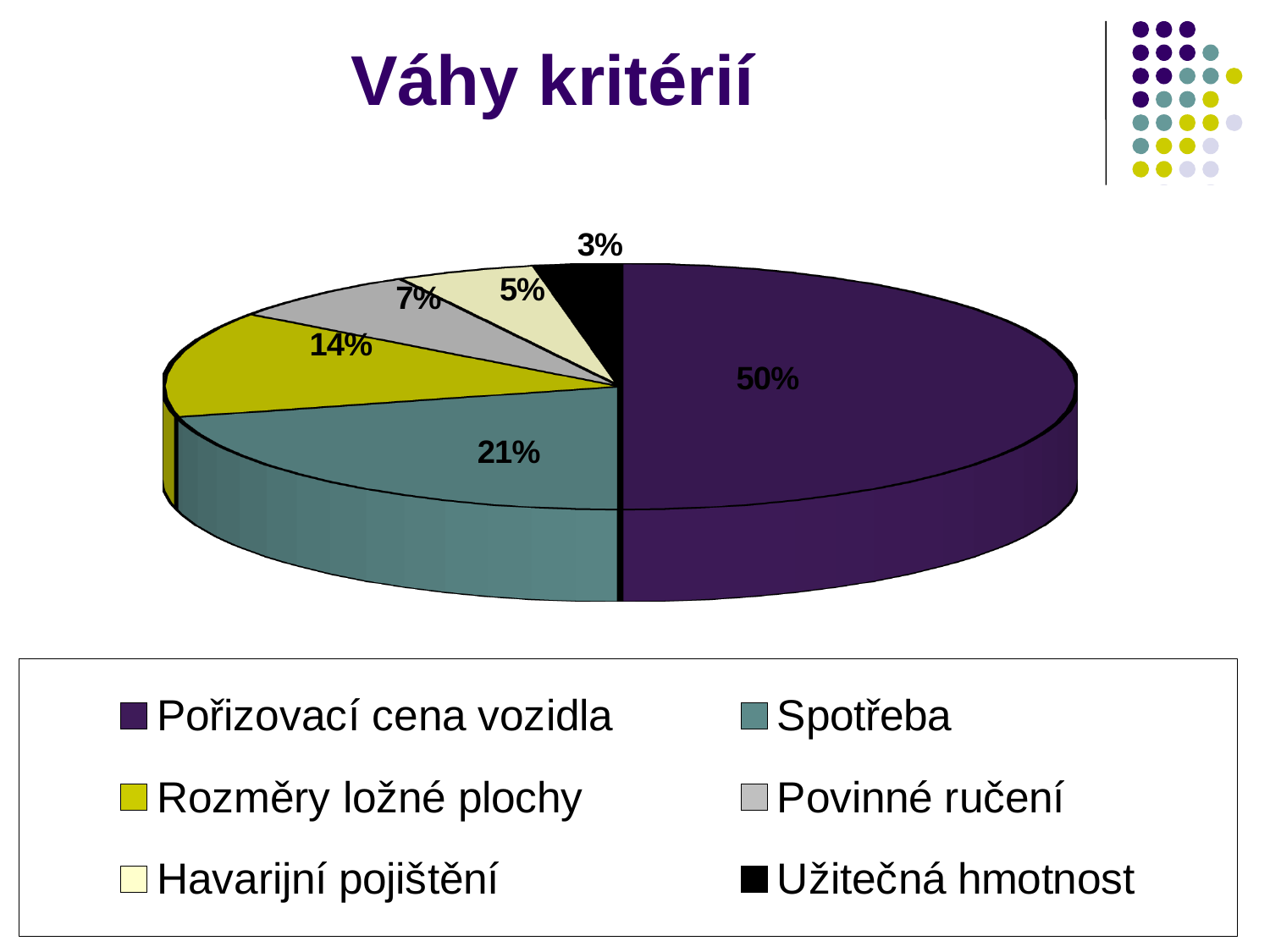
Which category has the largest slice of the pie? Pořizovací cena vozidla What share of the pie does Pořizovací cena vozidla have? 50% What share of the pie does Povinné ručení have? 7% What is the title of the chart? Váhy kritérií How many categories does the pie chart show? 6 What is the difference in percentage points between Spotřeba and Rozměry ložné plochy? 7 What share of the pie does Spotřeba have? 21% What type of chart is shown on the slide? Pie chart Which is larger, the share for Havarijní pojištění or the share for Povinné ručení? Povinné ručení Which category has the smallest slice of the pie? Užitečná hmotnost